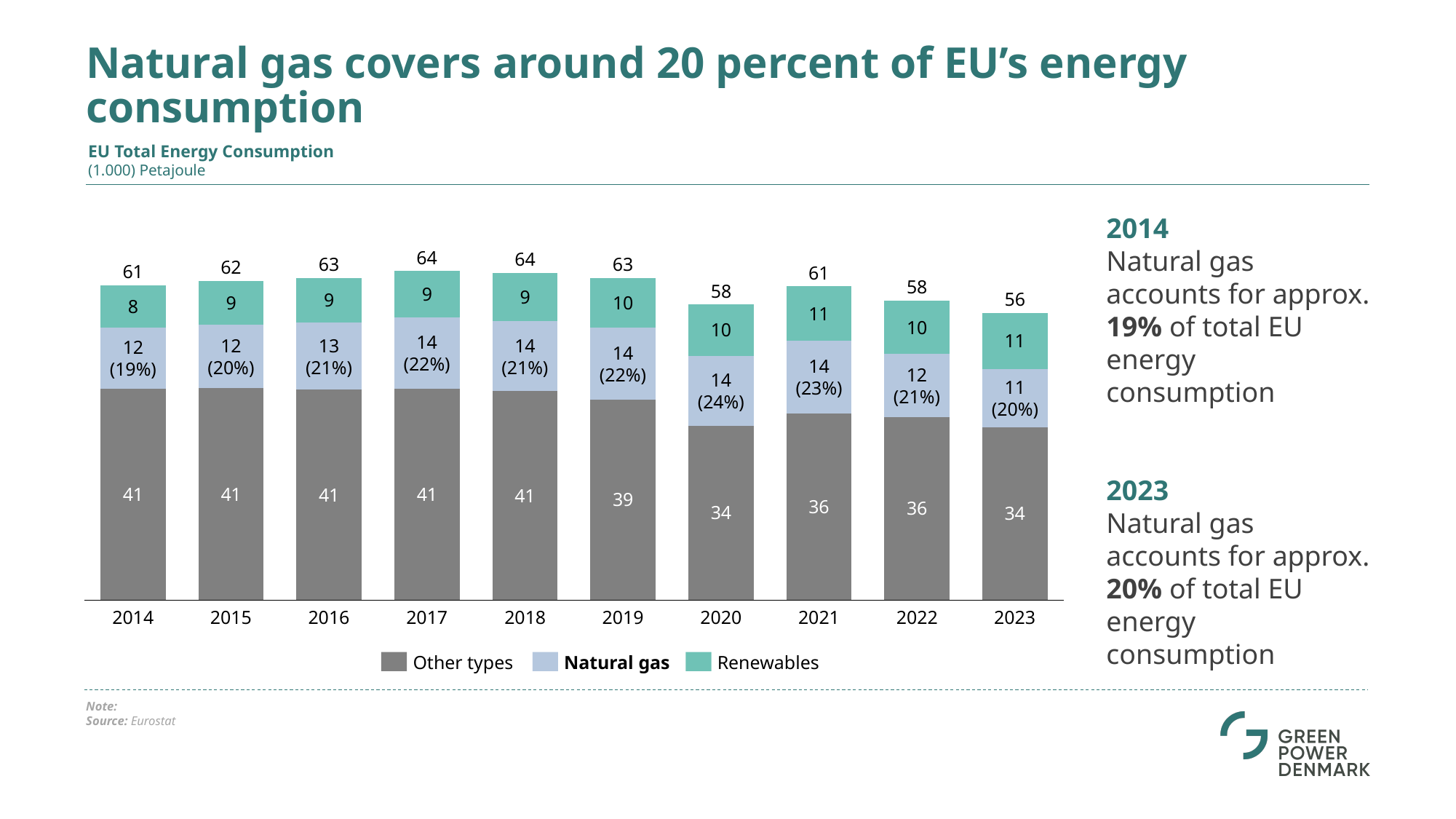
How many years are shown on the x axis? 10 What is the total energy consumption shown for 2017? 64 What is the value for Other types in 2019? 39 What is the value for Renewables in 2014? 8 Does the Renewables value rise or fall from 2014 to 2023? Rise What is the difference between the total for 2014 and the total for 2023? 5 What share of total EU energy consumption does Natural gas account for in 2020? 24% Which is larger, the Other types value in 2018 or the Other types value in 2021? 2018 Which year has the lowest total energy consumption? 2023 What is the value for Natural gas in 2020? 14 What kind of chart is shown on the slide? Stacked bar chart How many series does the legend list? 3